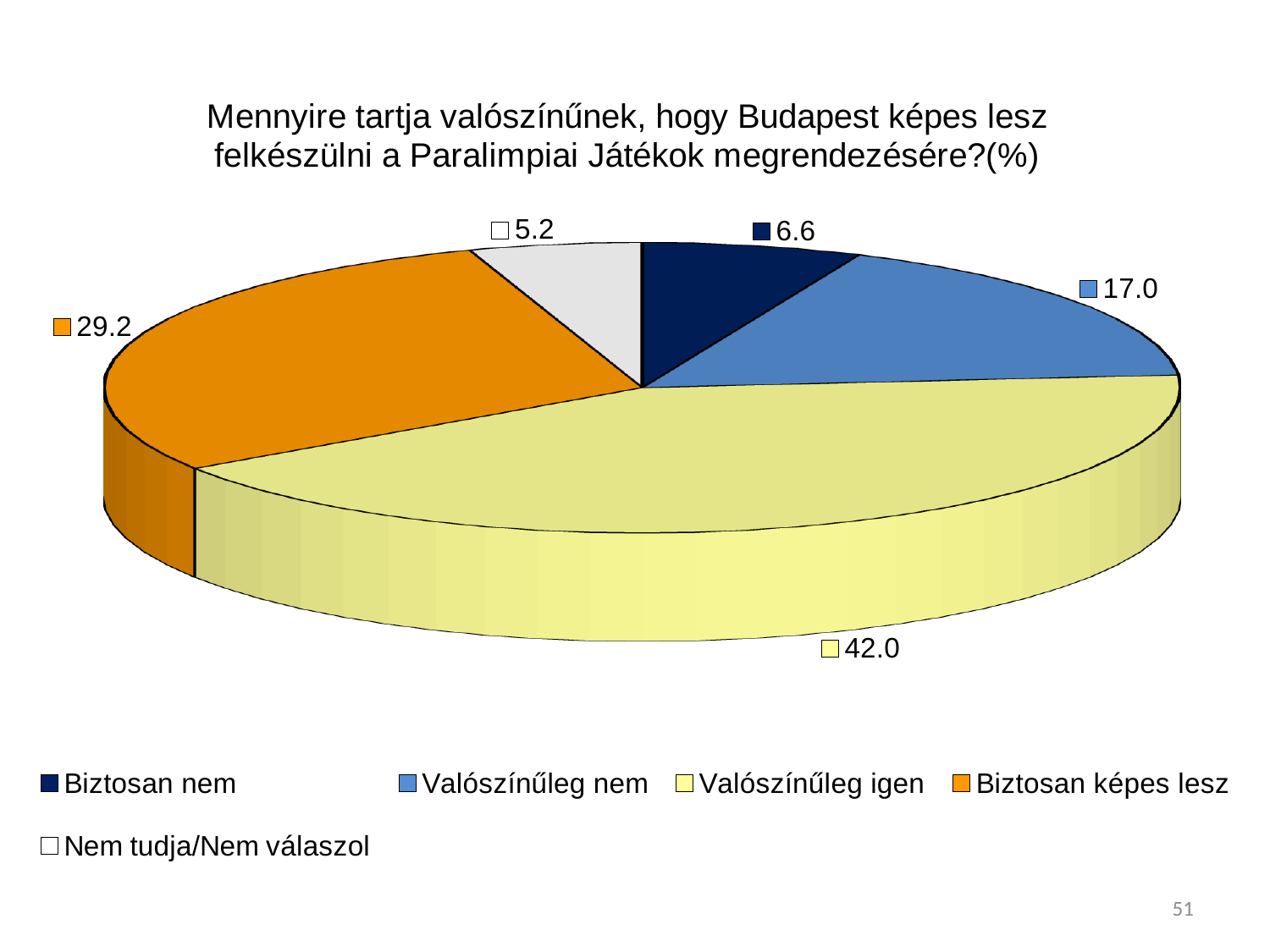
Which is larger, the value for "Valószínűleg nem" or the value for "Biztosan nem"? Valószínűleg nem What value is shown for the "Valószínűleg igen" slice? 42.0 What value is shown for the "Biztosan képes lesz" slice? 29.2 What is the difference between the values for "Valószínűleg igen" and "Biztosan képes lesz"? 12.8 What value is shown for the "Biztosan nem" slice? 6.6 What type of chart is shown on the slide? Pie chart Which category has the largest slice of the pie? Valószínűleg igen Which category has the smallest slice of the pie? Nem tudja/Nem válaszol Which colour represents the "Biztosan képes lesz" category in the legend? Orange How many slices does the pie chart have? 5 What value is shown for the "Nem tudja/Nem válaszol" slice? 5.2 What value is shown for the "Valószínűleg nem" slice? 17.0